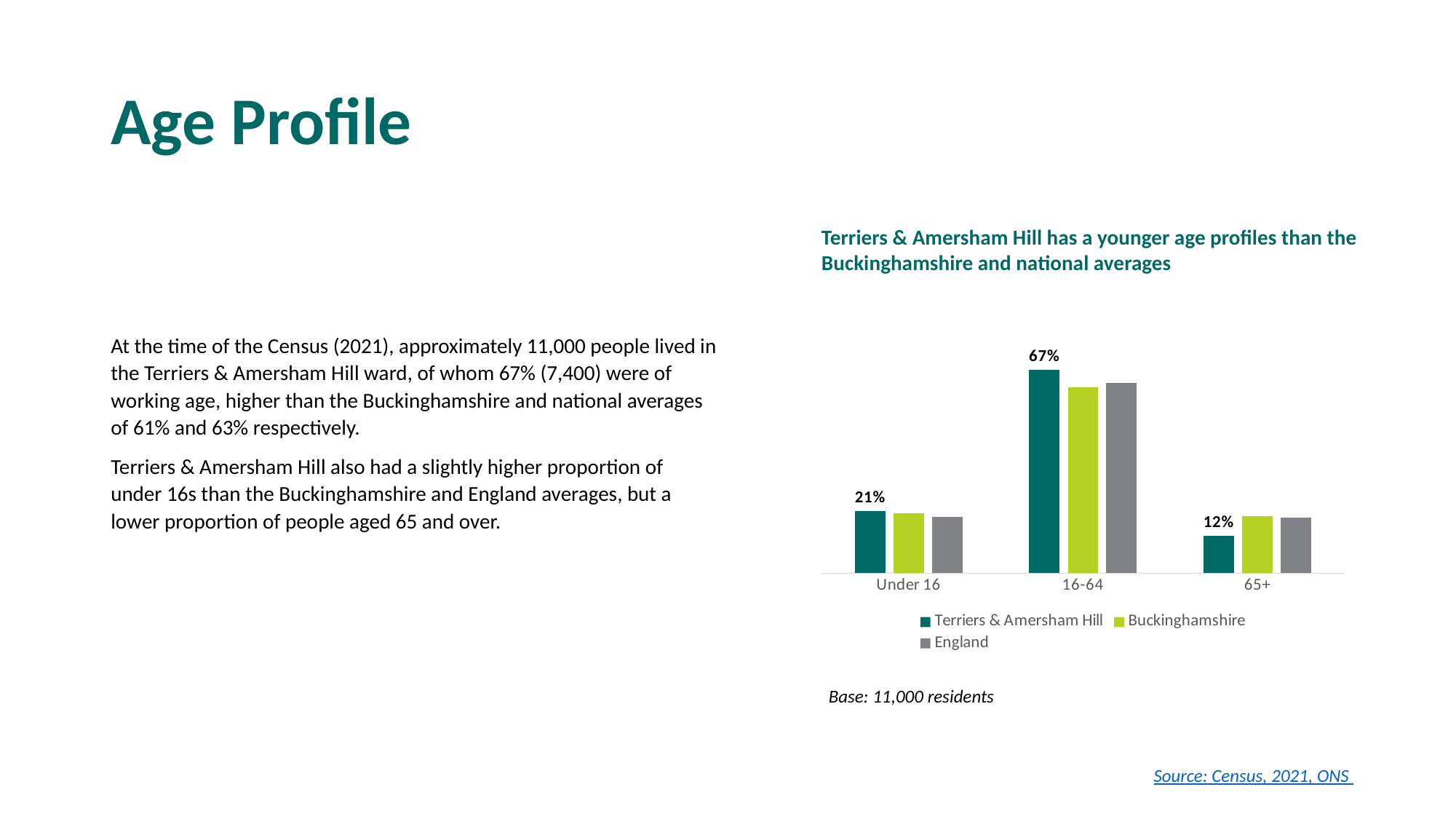
How many series does the chart's legend list? 3 What is the difference between the Terriers & Amersham Hill values for 16-64 and Under 16? 46 percentage points What kind of chart is shown on the slide? Bar chart What is the value for Terriers & Amersham Hill in the 16-64 age group? 67% How many age group categories are shown on the x axis of the chart? 3 In the 65+ age group, which is larger: Terriers & Amersham Hill or England? England Which age group has the lowest value for Terriers & Amersham Hill? 65+ Which age group has the highest value for Terriers & Amersham Hill? 16-64 What is the difference between the Terriers & Amersham Hill values for Under 16 and 65+? 9 percentage points What is the value for Terriers & Amersham Hill in the 65+ age group? 12% In the 16-64 age group, which is larger: Terriers & Amersham Hill or Buckinghamshire? Terriers & Amersham Hill What is the value for Terriers & Amersham Hill in the Under 16 age group? 21%